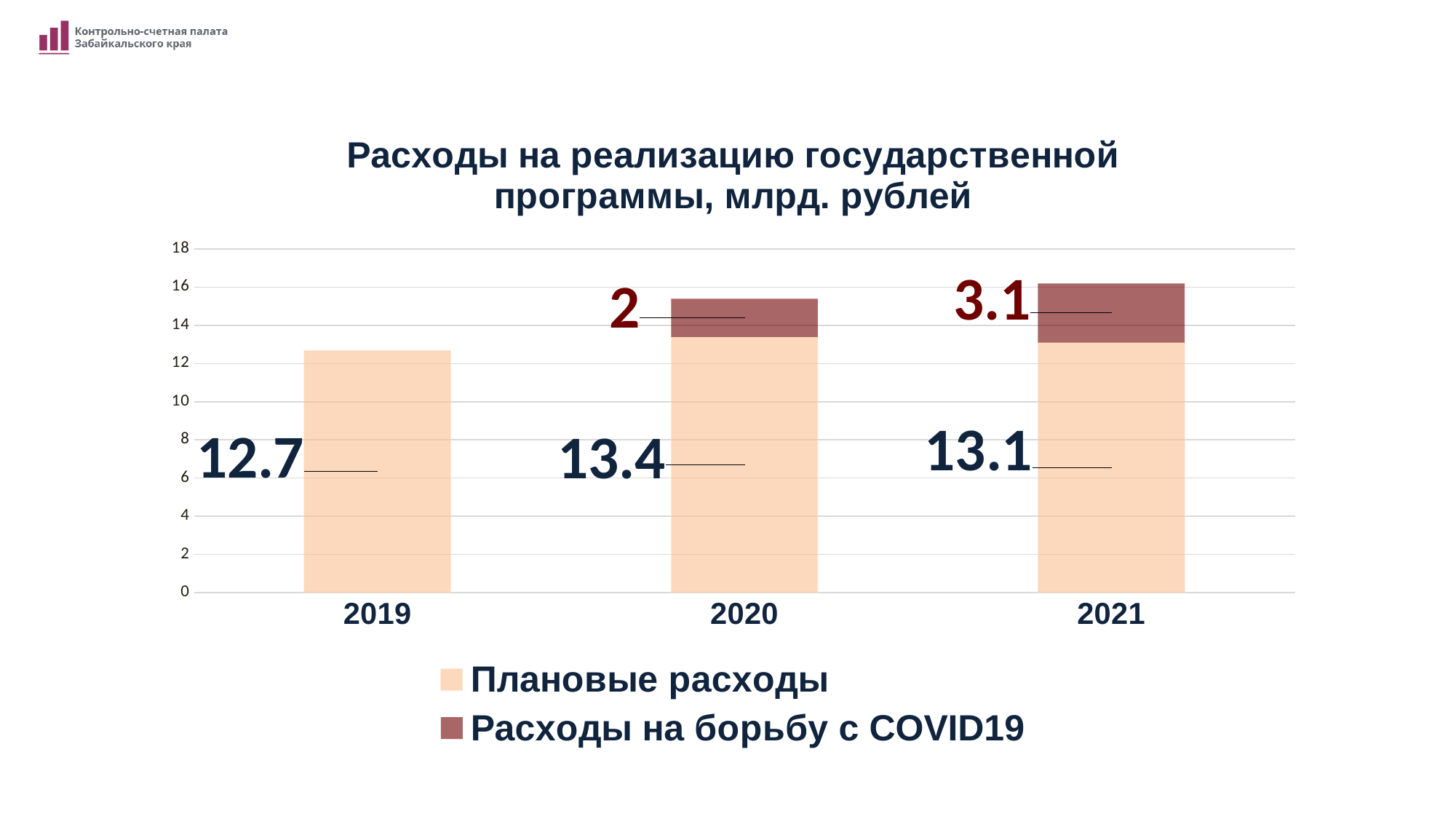
What is the value of Плановые расходы for 2020? 13.4 What is the value of Расходы на борьбу с COVID19 for 2020? 2 How many series does the legend list? 2 Which year has the lowest value of Плановые расходы? 2019 Which is larger: Расходы на борьбу с COVID19 in 2020 or in 2021? 2021 What is the difference between Плановые расходы in 2020 and 2019? 0.7 What is the value of Плановые расходы for 2019? 12.7 Which year has the highest value of Плановые расходы? 2020 What is the total height of the stacked bar for 2021? 16.2 What is the value of Расходы на борьбу с COVID19 for 2021? 3.1 What type of chart is shown on the slide? Stacked bar chart How many years are shown on the x axis? 3